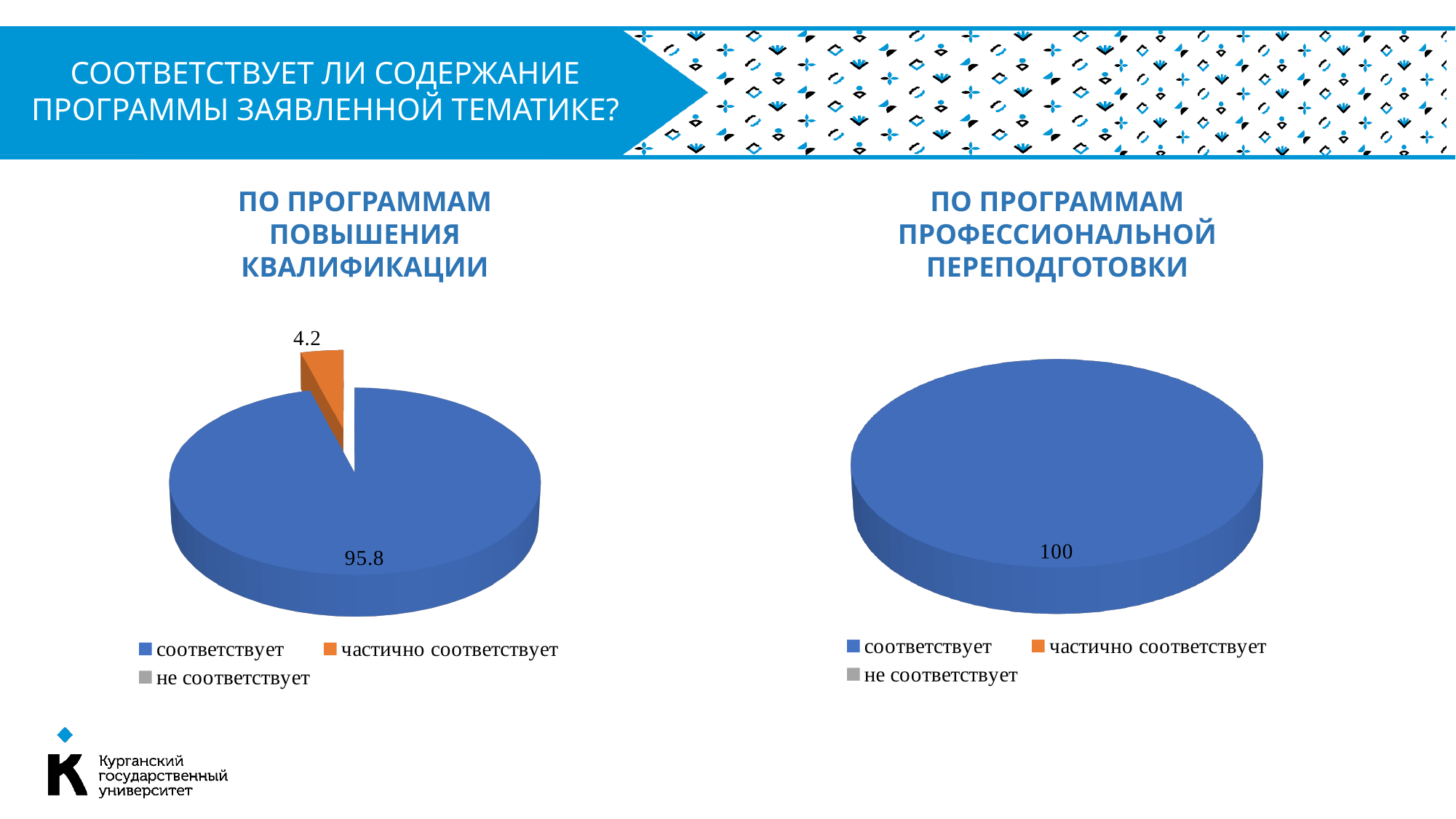
How many entries does the legend of the right chart (ПО ПРОГРАММАМ ПРОФЕССИОНАЛЬНОЙ ПЕРЕПОДГОТОВКИ) list? 3 How many slices with data labels are visible in the left chart (ПО ПРОГРАММАМ ПОВЫШЕНИЯ КВАЛИФИКАЦИИ)? 2 In the left chart (ПО ПРОГРАММАМ ПОВЫШЕНИЯ КВАЛИФИКАЦИИ), which of the two labelled slices is smaller? частично соответствует In the left chart (ПО ПРОГРАММАМ ПОВЫШЕНИЯ КВАЛИФИКАЦИИ), which is larger: 'соответствует' or 'частично соответствует'? соответствует In the left chart (ПО ПРОГРАММАМ ПОВЫШЕНИЯ КВАЛИФИКАЦИИ), what is the difference between the 'соответствует' and 'частично соответствует' values? 91.6 What type of chart is used on the right side of the slide? Pie chart What type of chart is used on the left side of the slide? Pie chart In the left chart (ПО ПРОГРАММАМ ПОВЫШЕНИЯ КВАЛИФИКАЦИИ), which category has the largest slice? соответствует In the left chart (ПО ПРОГРАММАМ ПОВЫШЕНИЯ КВАЛИФИКАЦИИ), what is the value for 'частично соответствует'? 4.2 In the right chart (ПО ПРОГРАММАМ ПРОФЕССИОНАЛЬНОЙ ПЕРЕПОДГОТОВКИ), what is the value for 'соответствует'? 100 What colour represents 'частично соответствует' in the legends of both charts? Orange In the left chart (ПО ПРОГРАММАМ ПОВЫШЕНИЯ КВАЛИФИКАЦИИ), what is the value for 'соответствует'? 95.8